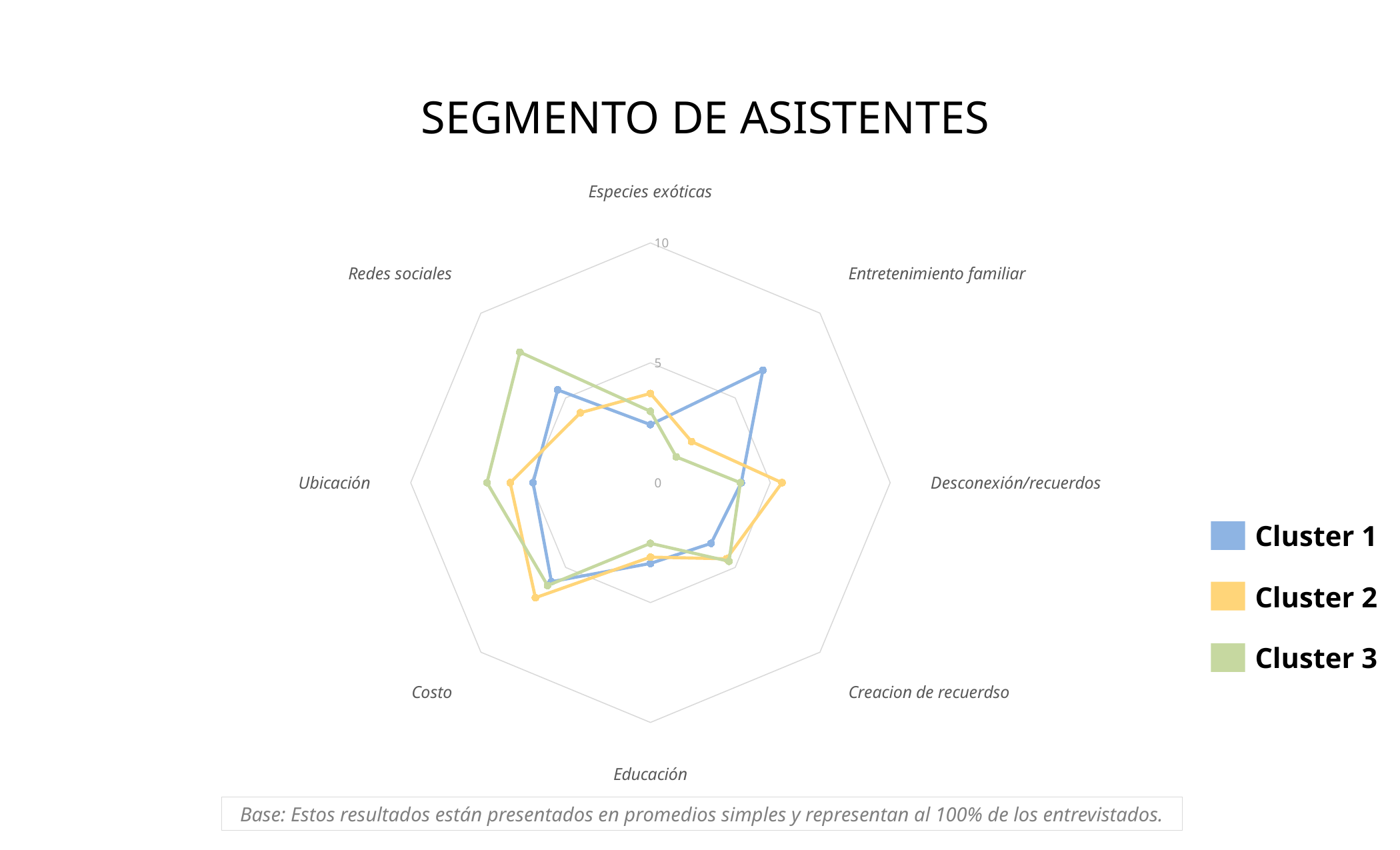
Which cluster has the higher value for Redes sociales, Cluster 2 or Cluster 3? Cluster 3 How many categories (axes) does the radar chart have? 8 Is the value for Cluster 1 on Entretenimiento familiar greater or less than 5? greater Is the value for Cluster 1 on Educación greater or less than 5? less What kind of chart is shown on the slide? Radar chart Which cluster has the highest value for Entretenimiento familiar? Cluster 1 Is the value for Cluster 3 on Entretenimiento familiar greater or less than 5? less Which cluster has the higher value for Ubicación, Cluster 1 or Cluster 3? Cluster 3 How many series does the legend list? 3 Which colour represents Cluster 3 in the legend? Green What is the title of the chart? SEGMENTO DE ASISTENTES